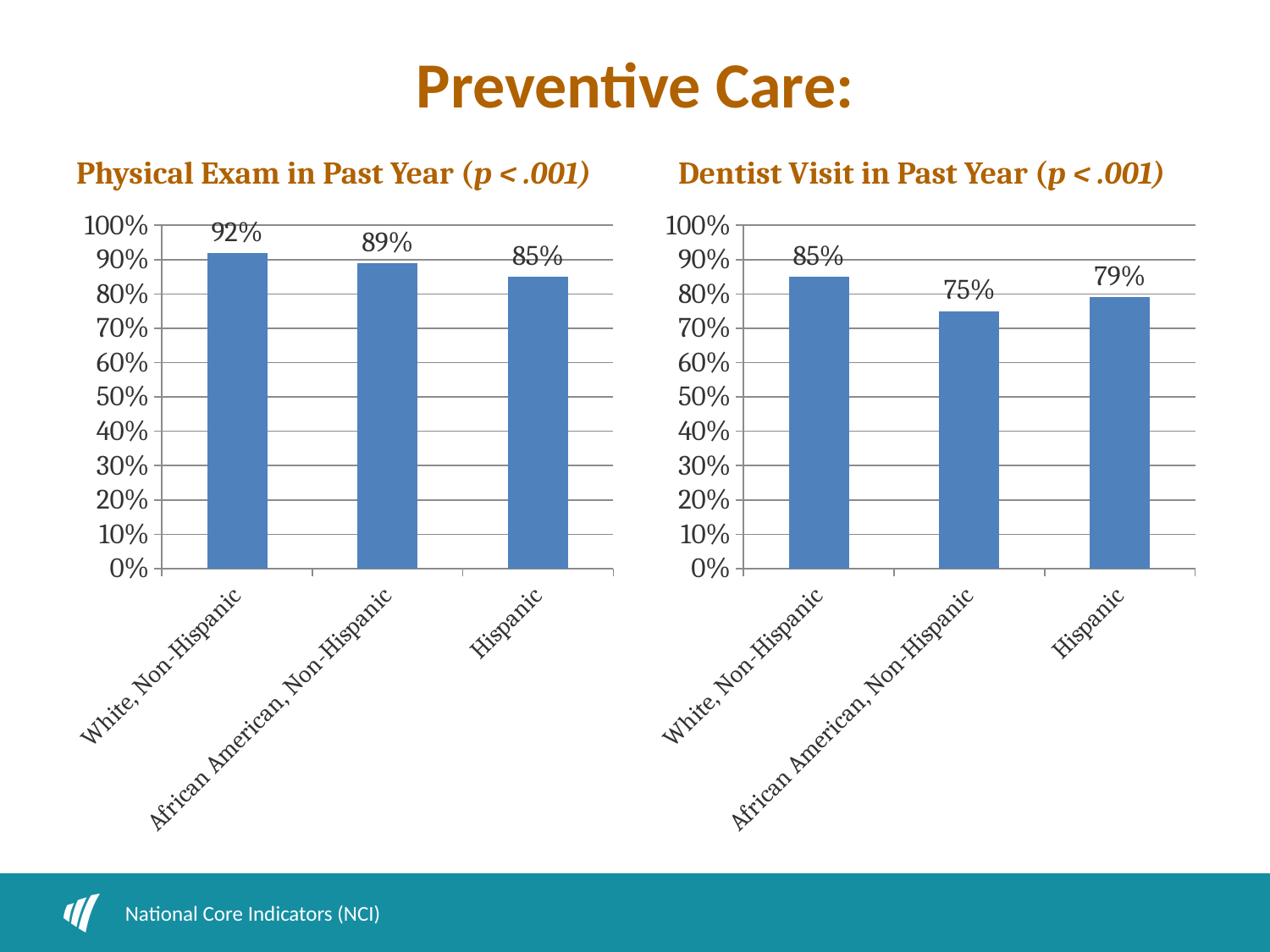
In the Dentist Visit in Past Year chart, which category has the lowest value? African American, Non-Hispanic In the Physical Exam in Past Year chart, what is the difference between the White, Non-Hispanic and Hispanic values? 7% How many categories are shown in the Physical Exam in Past Year chart? 3 In the Physical Exam in Past Year chart, do the values rise or fall from left to right? Fall In the Dentist Visit in Past Year chart, what is the difference between the White, Non-Hispanic and African American, Non-Hispanic values? 10% In the Dentist Visit in Past Year chart, what is the value for Hispanic? 79% In the Physical Exam in Past Year chart, what is the value for White, Non-Hispanic? 92% In the Physical Exam in Past Year chart, which category has the highest value? White, Non-Hispanic What kind of chart is the Dentist Visit in Past Year chart? Bar chart In the Dentist Visit in Past Year chart, which is larger: the value for Hispanic or the value for African American, Non-Hispanic? Hispanic In the Physical Exam in Past Year chart, what is the value for Hispanic? 85% In the Dentist Visit in Past Year chart, what is the value for African American, Non-Hispanic? 75%